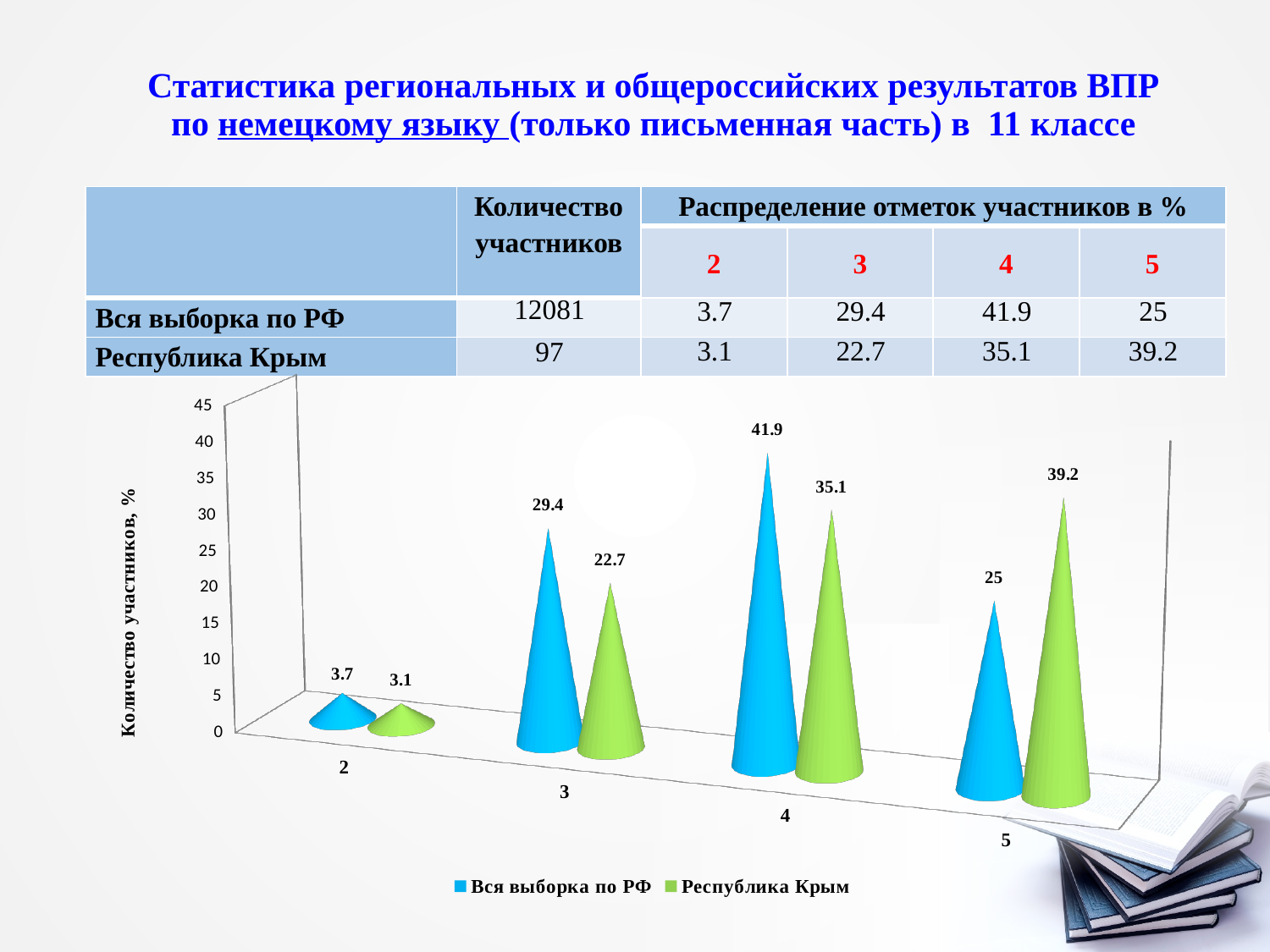
What is the label of the vertical axis of the chart? Количество участников, % How many series does the chart legend list? 2 Which mark has the highest value for "Вся выборка по РФ"? 4 What is the difference between "Вся выборка по РФ" and "Республика Крым" at mark 4? 6.8 What is the value for "Вся выборка по РФ" at mark 2? 3.7 What is the value for "Республика Крым" at mark 5? 39.2 At mark 5, which series has the larger value, "Вся выборка по РФ" or "Республика Крым"? Республика Крым How many marks (categories) are shown on the x axis of the chart? 4 What is the value for "Вся выборка по РФ" at mark 4? 41.9 What is the value for "Республика Крым" at mark 3? 22.7 Which mark has the lowest value for "Республика Крым"? 2 What kind of chart is shown on the slide? bar chart